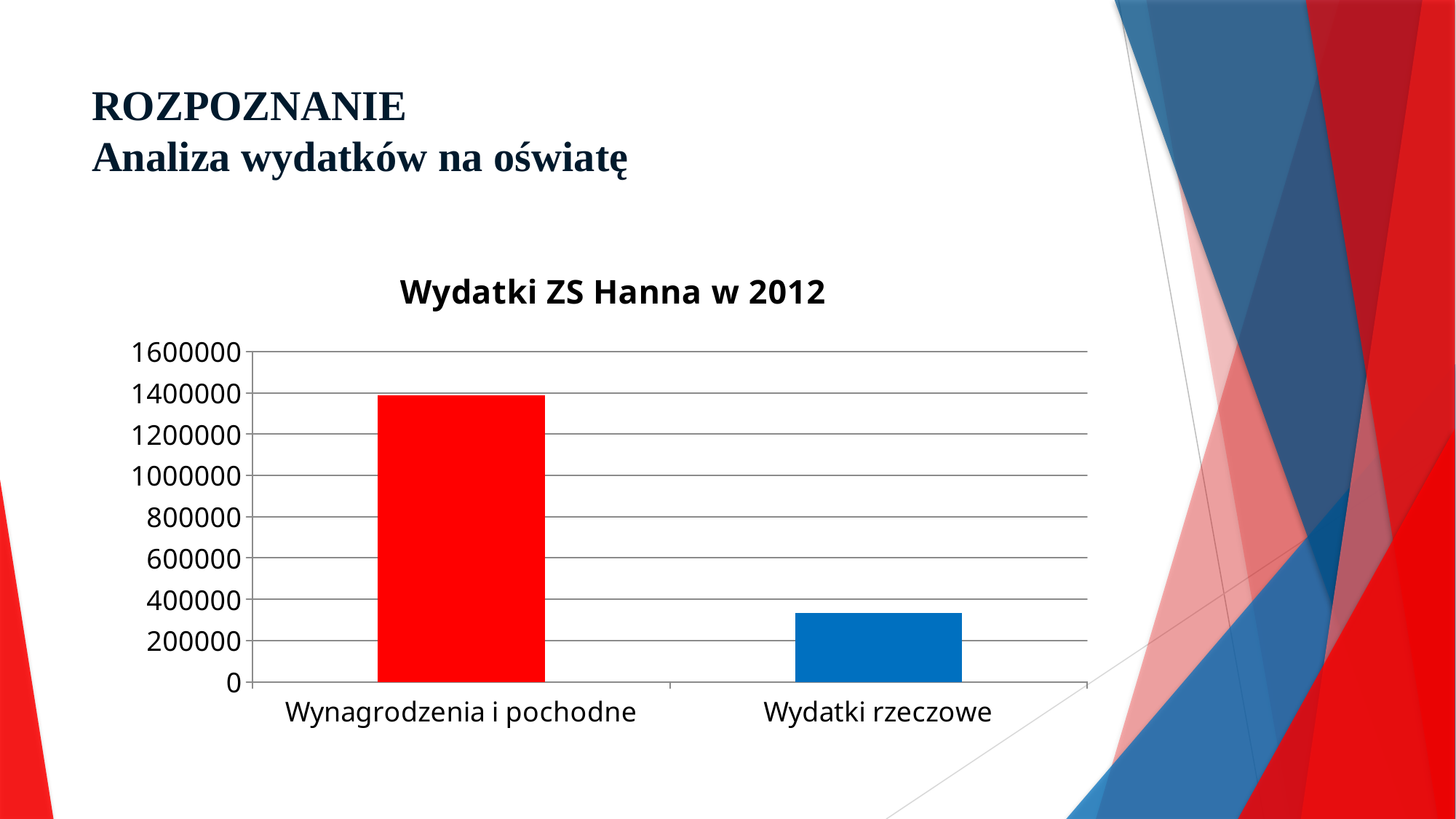
Which category has the highest value? Wynagrodzenia i pochodne Is the value for Wydatki rzeczowe greater or less than 400000? less Is the value for Wydatki rzeczowe greater or less than 200000? greater What colour is the bar for Wydatki rzeczowe? blue What is the title of the chart? Wydatki ZS Hanna w 2012 Which is larger, the value for Wynagrodzenia i pochodne or the value for Wydatki rzeczowe? Wynagrodzenia i pochodne Do the values rise or fall from left to right along the x axis? fall Which category has the lowest value? Wydatki rzeczowe Is the value for Wynagrodzenia i pochodne greater or less than 1600000? less How many categories are plotted in the chart? 2 What kind of chart is shown on the slide? bar chart